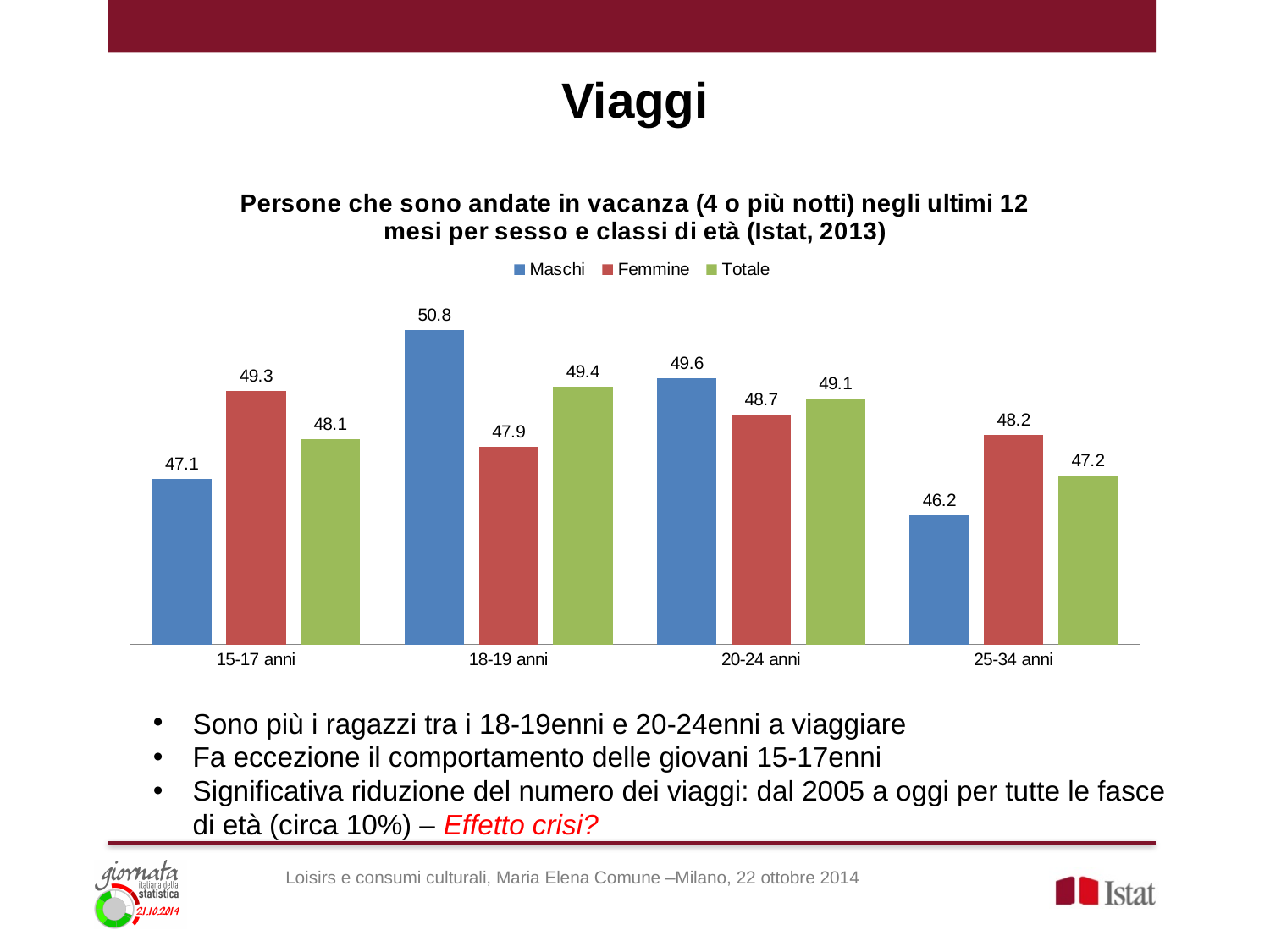
What is the difference between the Maschi and Femmine values in the 18-19 anni age group? 2.9 Which age group has the lowest Femmine value? 18-19 anni How many age groups are shown on the x axis? 4 Does the Totale value rise or fall from 20-24 anni to 25-34 anni? Fall Which age group has the highest Maschi value? 18-19 anni Which colour represents the Totale series in the chart? Green What is the value for Femmine in the 15-17 anni age group? 49.3 In the 15-17 anni age group, which is larger, the Maschi value or the Femmine value? Femmine What is the Totale value for the 25-34 anni age group? 47.2 How many series does the legend list? 3 What is the value for Maschi in the 18-19 anni age group? 50.8 What kind of chart is shown on the slide? Bar chart